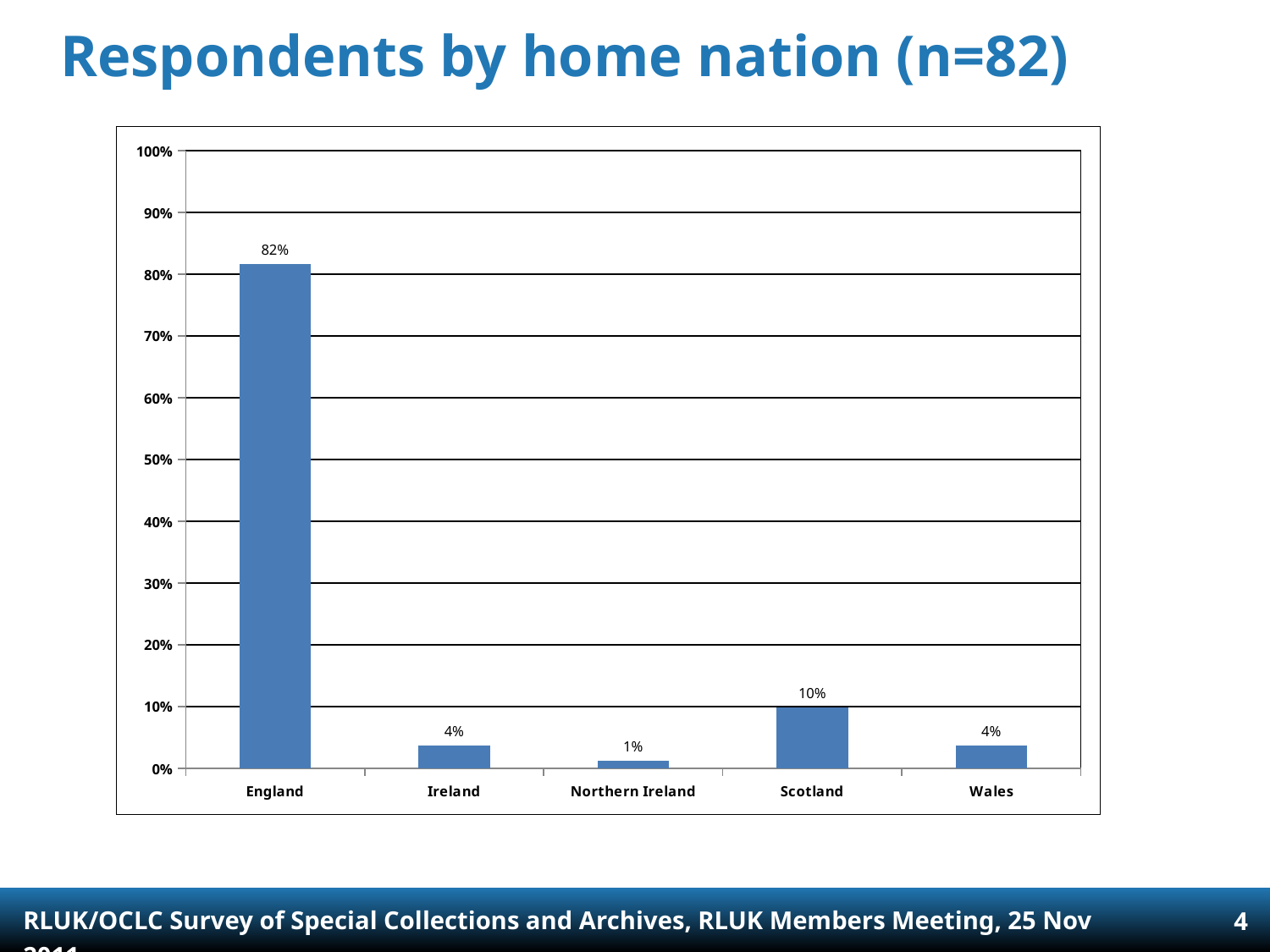
What percentage of respondents are from Wales? 4% How many home nations are shown on the x axis? 5 Which home nation has the highest share of respondents? England What is the difference in percentage points between England and Scotland? 72% What percentage of respondents are from Scotland? 10% What is the title of the chart on the slide? Respondents by home nation (n=82) Which has a larger share of respondents, Scotland or Ireland? Scotland What is the difference in percentage points between Scotland and Wales? 6% What percentage of respondents are from Northern Ireland? 1% Which home nation has the lowest share of respondents? Northern Ireland What type of chart is shown on the slide? Bar chart What percentage of respondents are from England? 82%